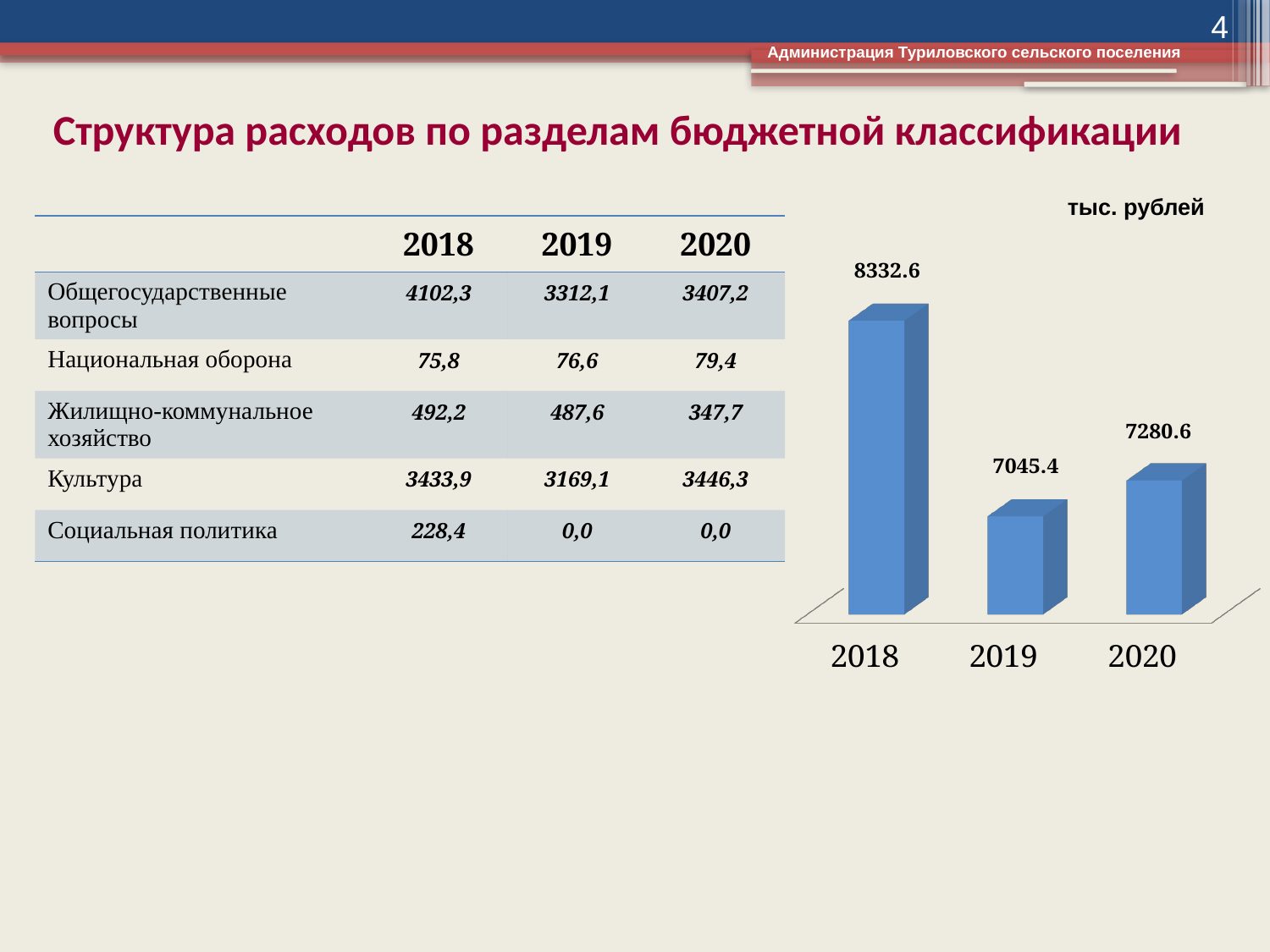
What is the difference between the 2018 and 2019 values on the bar chart? 1287.2 What unit is indicated above the bar chart? тыс. рублей Which year has the highest value on the bar chart? 2018 What is the difference between the 2020 and 2019 values on the bar chart? 235.2 On the bar chart, which is larger: the value for 2019 or the value for 2020? 2020 What is the value shown for 2019 on the bar chart? 7045.4 What type of chart is shown on the slide? bar chart Does the value on the bar chart rise or fall from 2018 to 2019? fall What is the value shown for 2018 on the bar chart? 8332.6 Which year has the lowest value on the bar chart? 2019 How many bars are plotted on the bar chart? 3 What is the value shown for 2020 on the bar chart? 7280.6